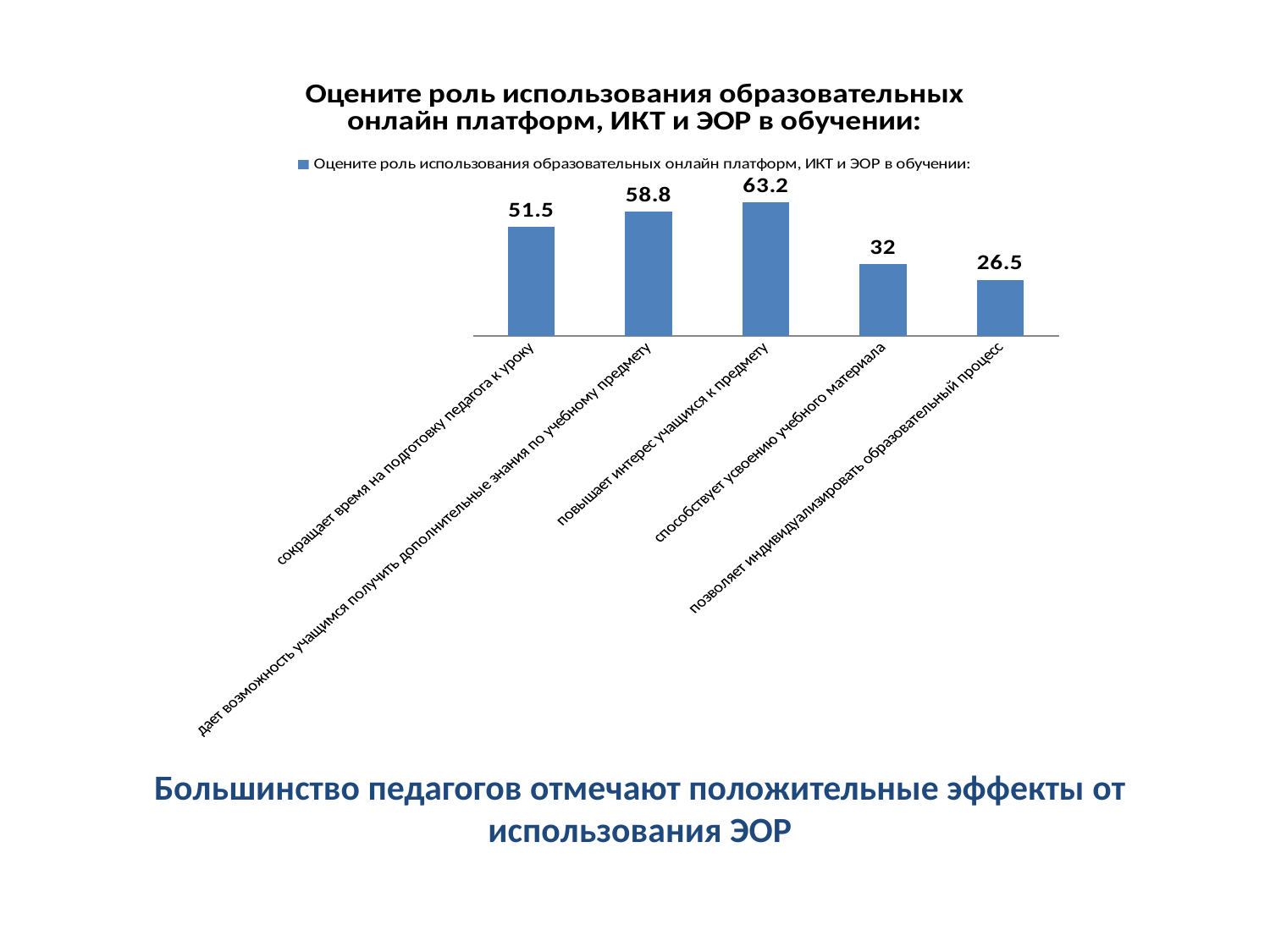
What kind of chart is shown on the slide? bar chart What is the difference between the values for 'повышает интерес учащихся к предмету' and 'позволяет индивидуализировать образовательный процесс'? 36.7 What value is shown for the category 'способствует усвоению учебного материала'? 32 What value is shown for the category 'сокращает время на подготовку педагога к уроку'? 51.5 What value is shown for the category 'позволяет индивидуализировать образовательный процесс'? 26.5 Which category has the lowest value? позволяет индивидуализировать образовательный процесс What is the difference between the values for 'дает возможность учащимся получить дополнительные знания по учебному предмету' and 'сокращает время на подготовку педагога к уроку'? 7.3 How many series does the legend list? 1 Which is larger: the value for 'способствует усвоению учебного материала' or the value for 'сокращает время на подготовку педагога к уроку'? сокращает время на подготовку педагога к уроку Which category has the highest value? повышает интерес учащихся к предмету How many categories are shown in the chart? 5 What value is shown for the category 'повышает интерес учащихся к предмету'? 63.2